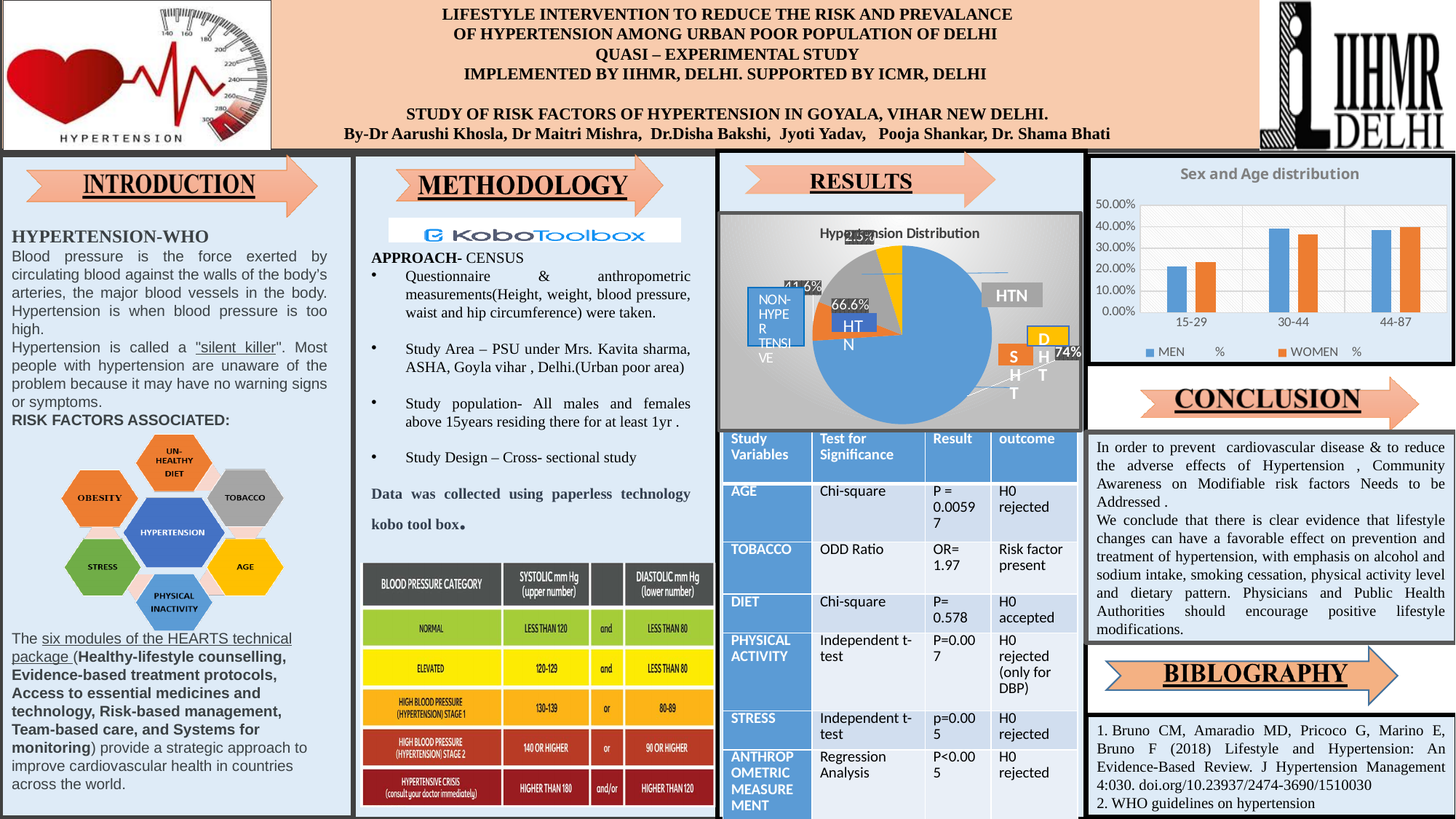
In the 'Sex and Age distribution' chart, which age group has the lowest value for MEN? 15-29 In the 'Sex and Age distribution' chart, which age group has the lowest value for WOMEN? 15-29 In the 'Sex and Age distribution' chart, what colour are the bars for WOMEN? orange In the 'Sex and Age distribution' chart, in the 30-44 age group, which is larger: MEN or WOMEN? MEN What type of chart is the 'Hypertension Distribution' chart? pie chart In the 'Sex and Age distribution' chart, how many age groups are shown on the x axis? 3 In the 'Sex and Age distribution' chart, is the value for WOMEN in the 30-44 group greater or less than 30.00%? greater In the 'Sex and Age distribution' chart, is the value for MEN in the 44-87 group greater or less than 30.00%? greater In the 'Sex and Age distribution' chart, how many series does the legend list? 2 In the 'Sex and Age distribution' chart, do the WOMEN values rise or fall from the 15-29 group to the 44-87 group? rise What type of chart is the 'Sex and Age distribution' chart? bar chart In the 'Sex and Age distribution' chart, is the value for MEN in the 15-29 group greater or less than 30.00%? less